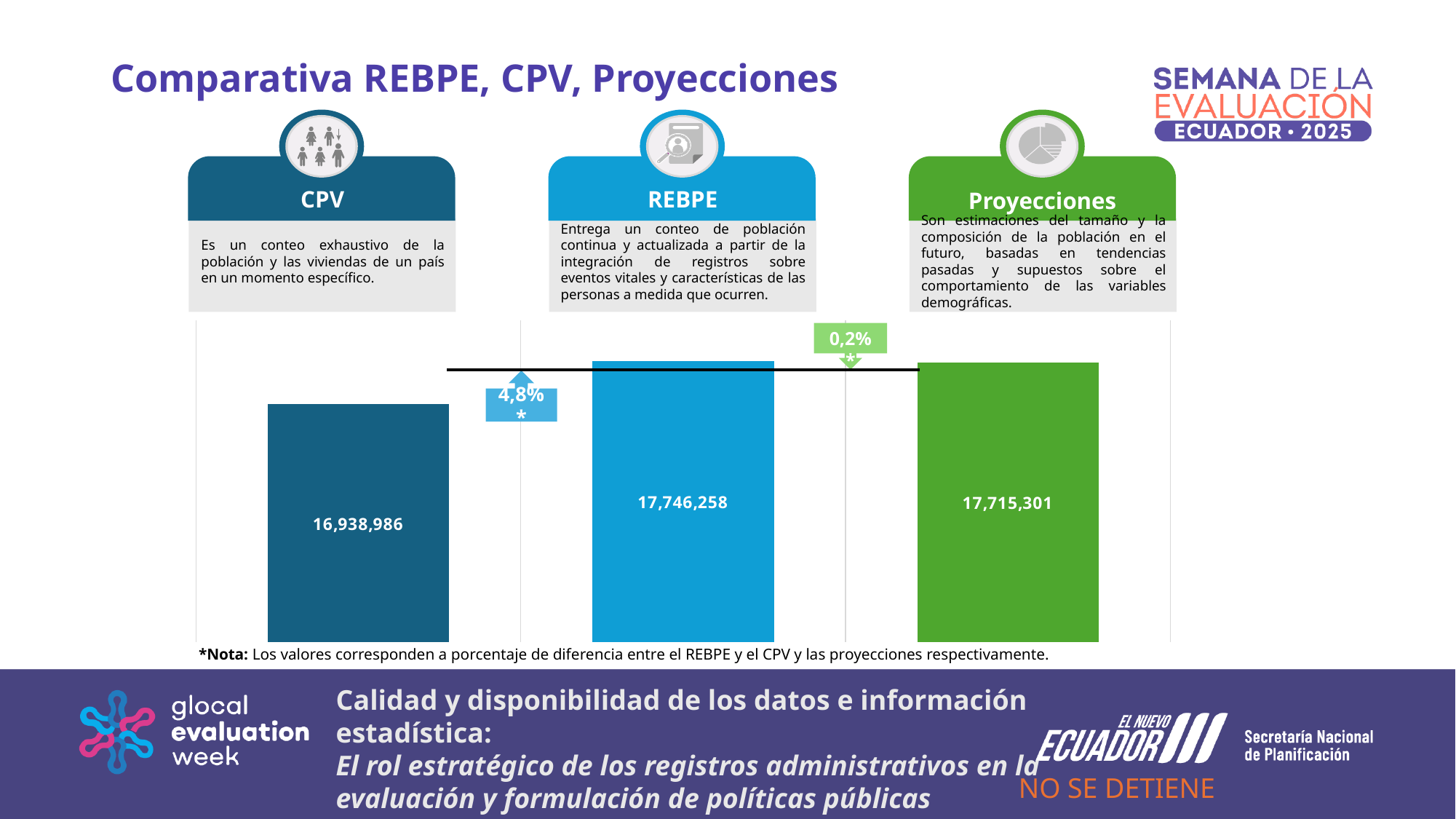
What is the difference between the REBPE value and the Proyecciones value? 30,957 What is the value shown for Proyecciones? 17,715,301 Which category has the highest value? REBPE What kind of chart is shown on the slide? Bar chart How many bars are plotted in the chart? 3 What is the difference between the REBPE value and the CPV value? 807,272 What is the value shown for REBPE? 17,746,258 What percentage difference is annotated between REBPE and CPV? 4,8% Which category has the lowest value? CPV What is the title of the slide's chart? Comparativa REBPE, CPV, Proyecciones Which is larger, the value for Proyecciones or the value for CPV? Proyecciones What is the value shown for CPV? 16,938,986